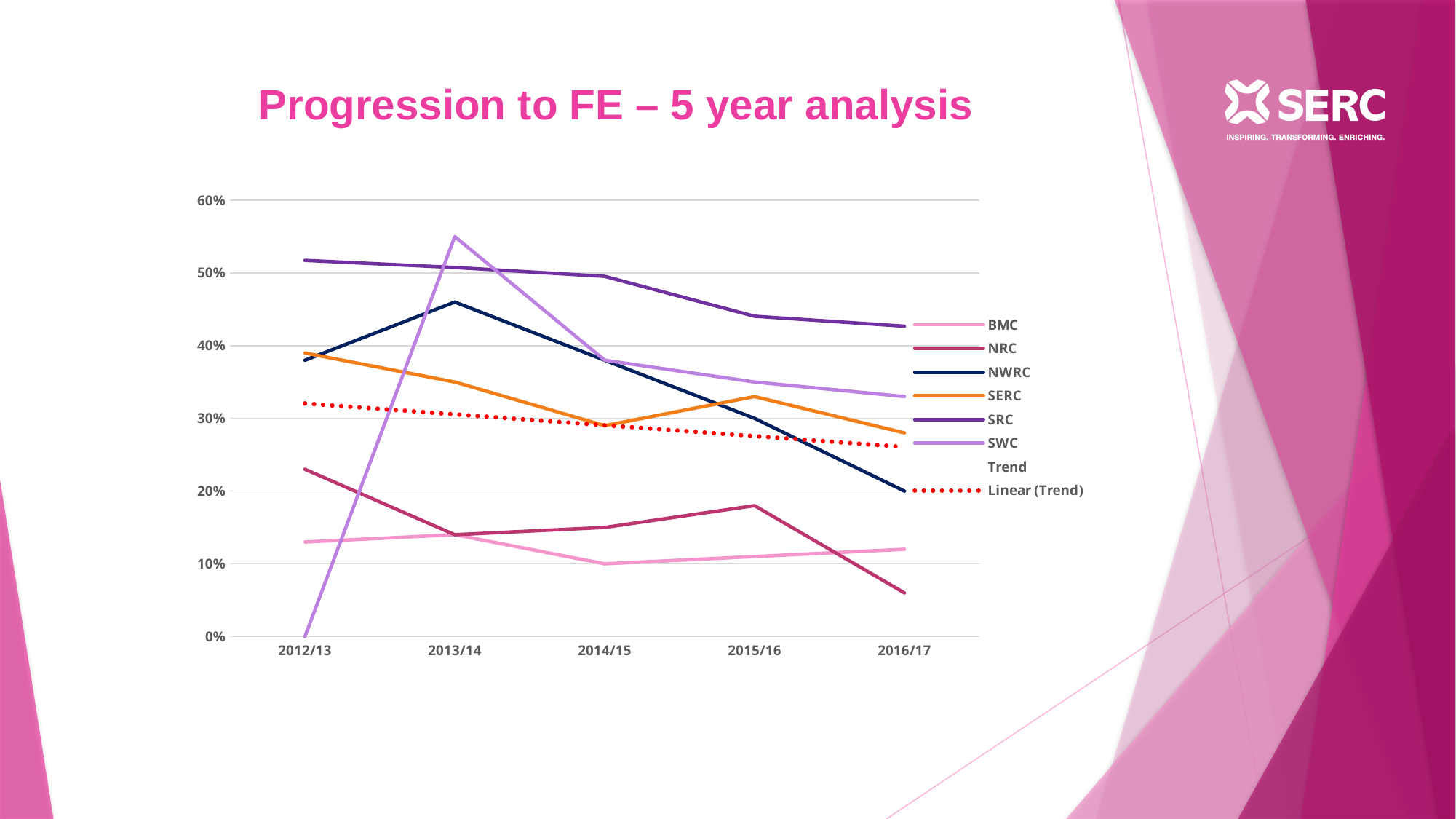
Which series has the highest value in 2013/14? SWC Is the value for NRC in 2016/17 greater or less than 10%? less What is the value for NWRC in 2016/17? 20% Does the SRC line rise or fall from 2012/13 to 2016/17? fall In 2015/16, which is larger: SRC or SERC? SRC Which series has the lowest value in 2016/17? NRC What kind of chart is shown on the slide? line chart What is the title of the chart? Progression to FE – 5 year analysis How many academic years are shown on the x axis? 5 Is the value for SRC in 2012/13 greater or less than 50%? greater How many entries does the legend list? 8 What is the value for SWC in 2012/13? 0%